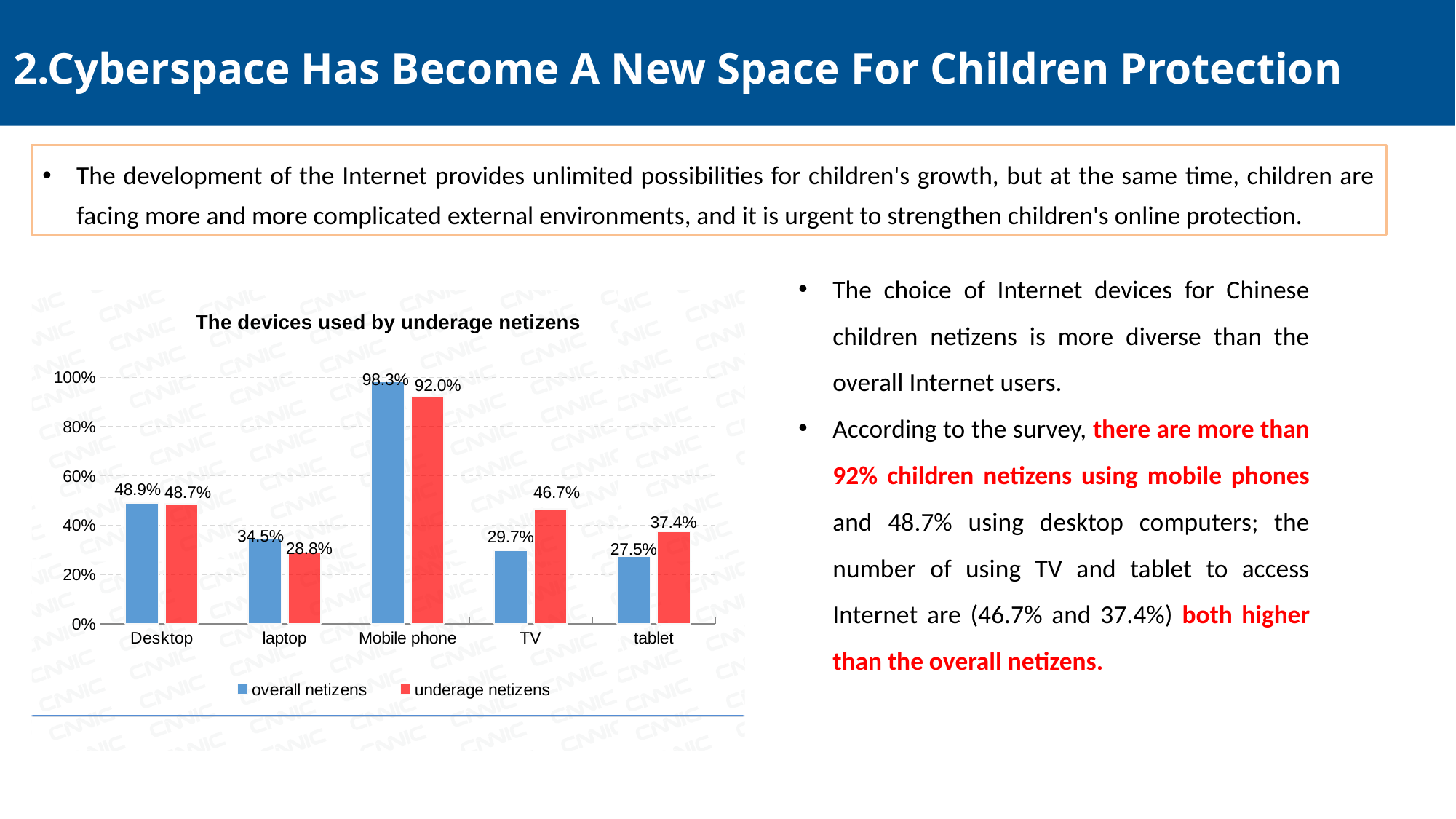
Which device has the lowest value for underage netizens? laptop Which device has the highest value for overall netizens? Mobile phone What is the title of the chart? The devices used by underage netizens What is the value for underage netizens using a mobile phone? 92.0% What is the difference between underage netizens and overall netizens for TV? 17.0% Is the value for overall netizens using a mobile phone greater or less than 80%? greater Which is larger for laptop: overall netizens or underage netizens? overall netizens How many series does the legend list? 2 How many device categories are shown on the x axis? 5 What is the value for underage netizens using a tablet? 37.4% What kind of chart is shown on the slide? bar chart What is the value for overall netizens using a desktop? 48.9%